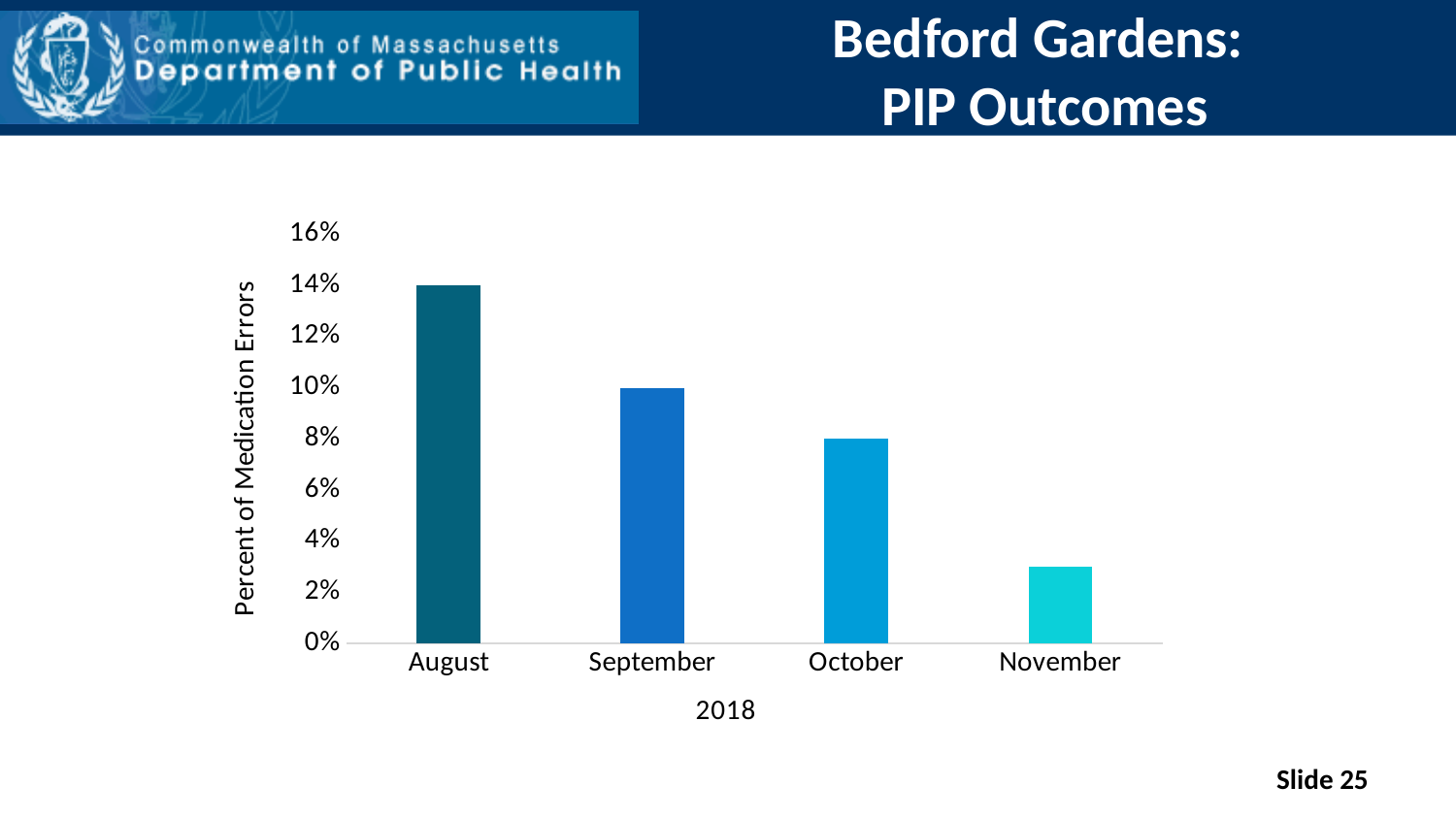
Is the value for November greater or less than 2%? greater What is the label on the y axis of the chart? Percent of Medication Errors What kind of chart is shown on the slide? bar chart What is the percent of medication errors for September? 10% Which month has the lowest percent of medication errors? November What is the percent of medication errors for October? 8% Which is larger, the value for September or the value for October? September Which month has the highest percent of medication errors? August Do the values rise or fall from August to November? fall Is the value for November greater or less than 4%? less How many months are shown on the x axis of the chart? 4 What is the percent of medication errors for August? 14%